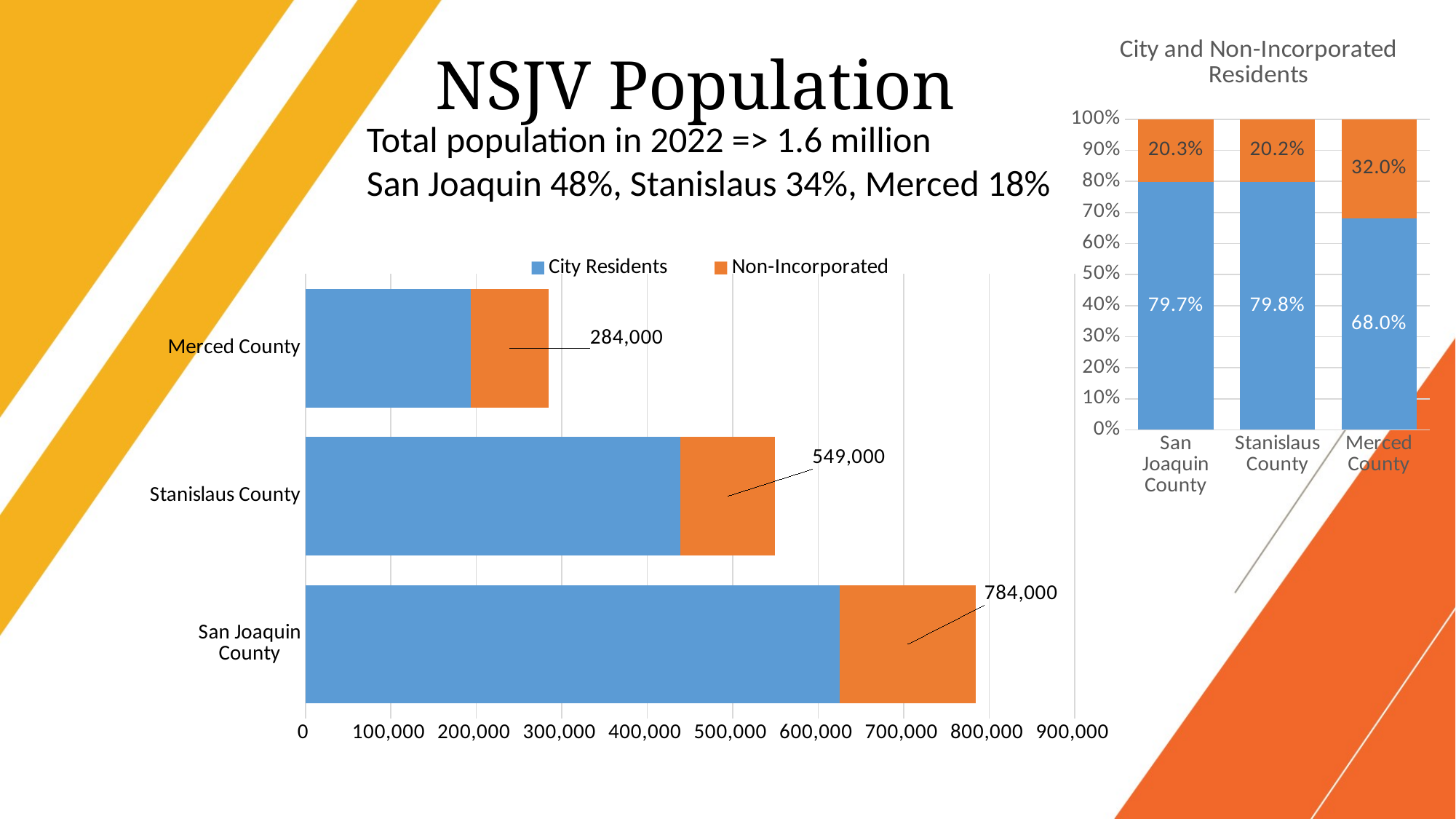
In the left-hand bar chart, what is the difference between the labelled totals for San Joaquin County and Stanislaus County? 235,000 In the 'City and Non-Incorporated Residents' chart, what is the Non-Incorporated percentage for San Joaquin County? 20.3% In the 'City and Non-Incorporated Residents' chart, which county has the highest Non-Incorporated share? Merced County In the left-hand bar chart, what is the total population labelled for San Joaquin County? 784,000 In the left-hand bar chart, which county has the lowest total population? Merced County In the left-hand bar chart, is the City Residents value for Stanislaus County greater or less than 400,000? greater In the left-hand bar chart, how many series does the legend list? 2 In the 'City and Non-Incorporated Residents' chart, what percentage of Merced County residents are city residents? 68.0% In the 'City and Non-Incorporated Residents' chart, what is the difference between the Non-Incorporated percentages for Merced County and Stanislaus County? 11.8% In the 'City and Non-Incorporated Residents' chart, how many counties are shown? 3 In the left-hand bar chart, what is the total population labelled for Merced County? 284,000 What kind of chart is the left-hand chart? Stacked bar chart